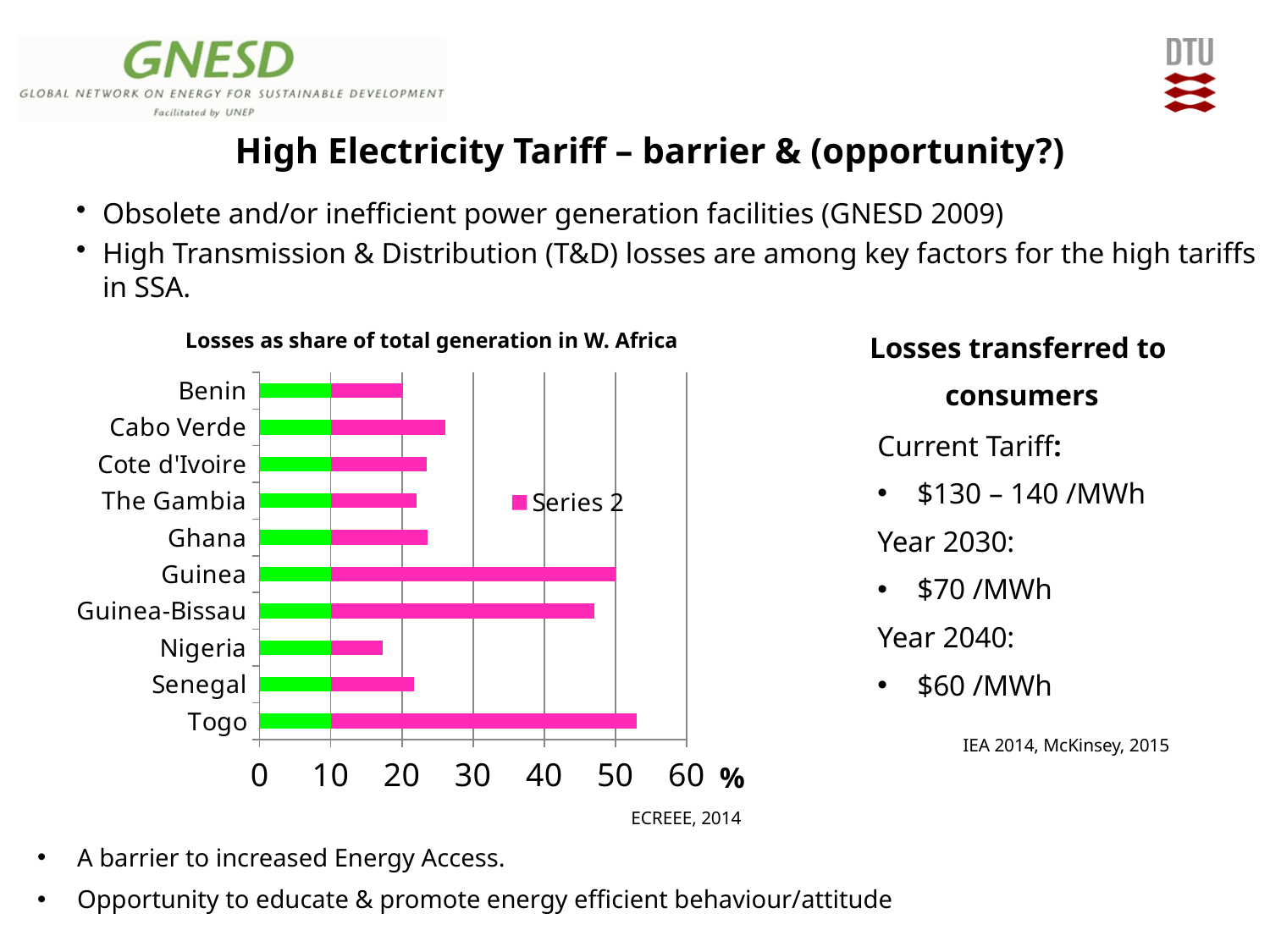
Is the total value for Nigeria greater or less than 20? less How many series does the chart legend list? 1 How many countries are listed on the chart? 10 What is the title of the chart? Losses as share of total generation in W. Africa Is the total value for Guinea-Bissau greater or less than 40? greater Which has the larger total bar, Cabo Verde or Benin? Cabo Verde Is the total value for Togo greater or less than 50? greater What is the only entry shown in the chart legend? Series 2 What kind of chart is shown on the slide? bar chart Which country has the highest losses as share of total generation? Togo Which has the larger total bar, Guinea or Guinea-Bissau? Guinea Which country has the lowest losses as share of total generation? Nigeria